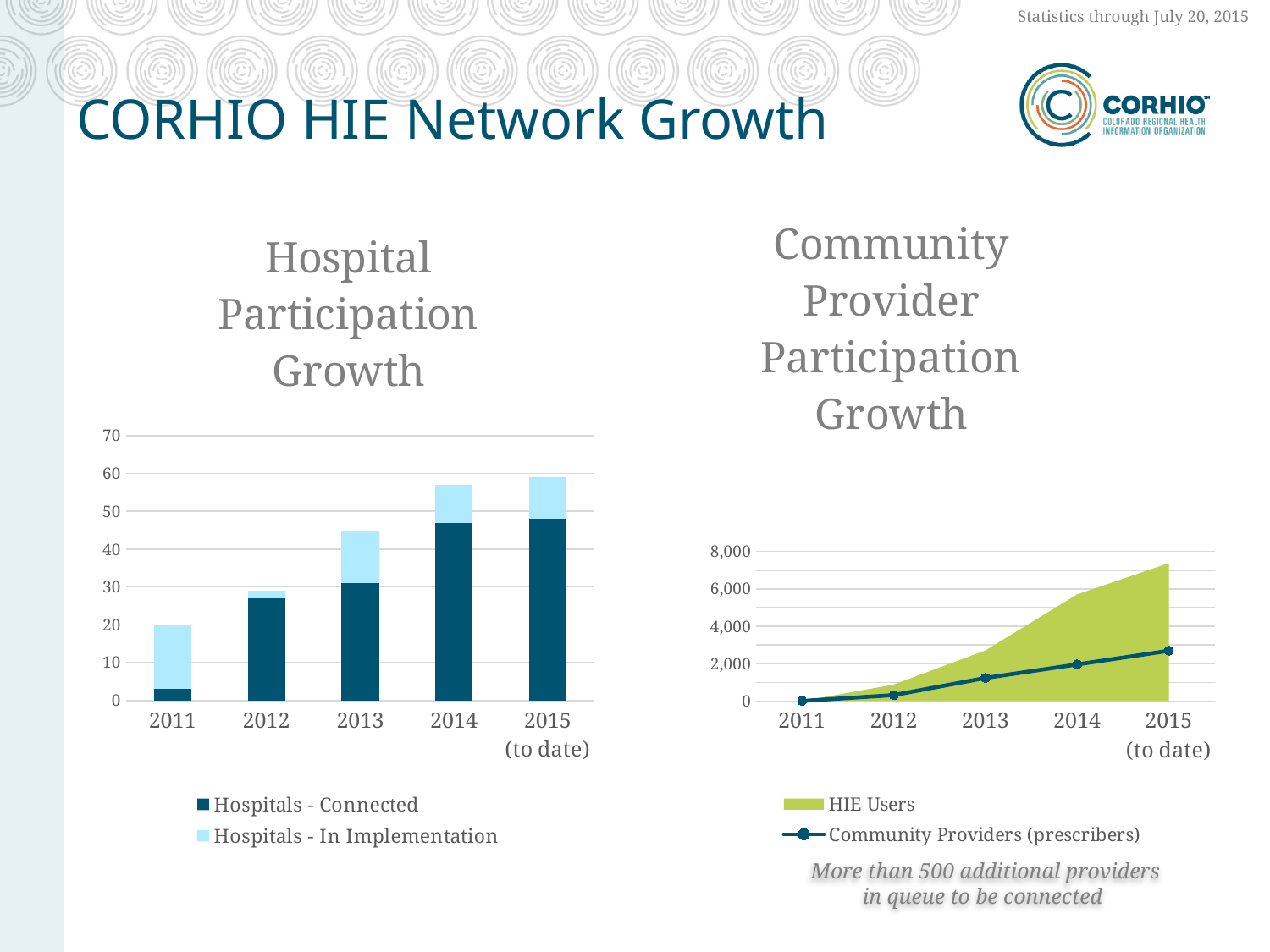
In the Community Provider Participation Growth chart, is the HIE Users value for 2015 (to date) greater or less than 6,000? greater In the Hospital Participation Growth chart, which is larger for 2013: Hospitals - Connected or Hospitals - In Implementation? Hospitals - Connected How many series does the legend of the Hospital Participation Growth chart list? 2 How many years are shown on the x axis of the Hospital Participation Growth chart? 5 In the Hospital Participation Growth chart, does the Hospitals - Connected series rise or fall from 2011 to 2015 (to date)? rise What kind of chart is the Hospital Participation Growth chart? Stacked bar chart In the Community Provider Participation Growth chart, which series is shown as a line with markers? Community Providers (prescribers) In the Hospital Participation Growth chart, is the Hospitals - Connected value for 2014 greater or less than 40? greater In the Hospital Participation Growth chart, which year has the smallest Hospitals - Connected segment? 2011 In the Community Provider Participation Growth chart, is the Community Providers (prescribers) value for 2015 (to date) greater or less than 2,000? greater How many series does the legend of the Community Provider Participation Growth chart list? 2